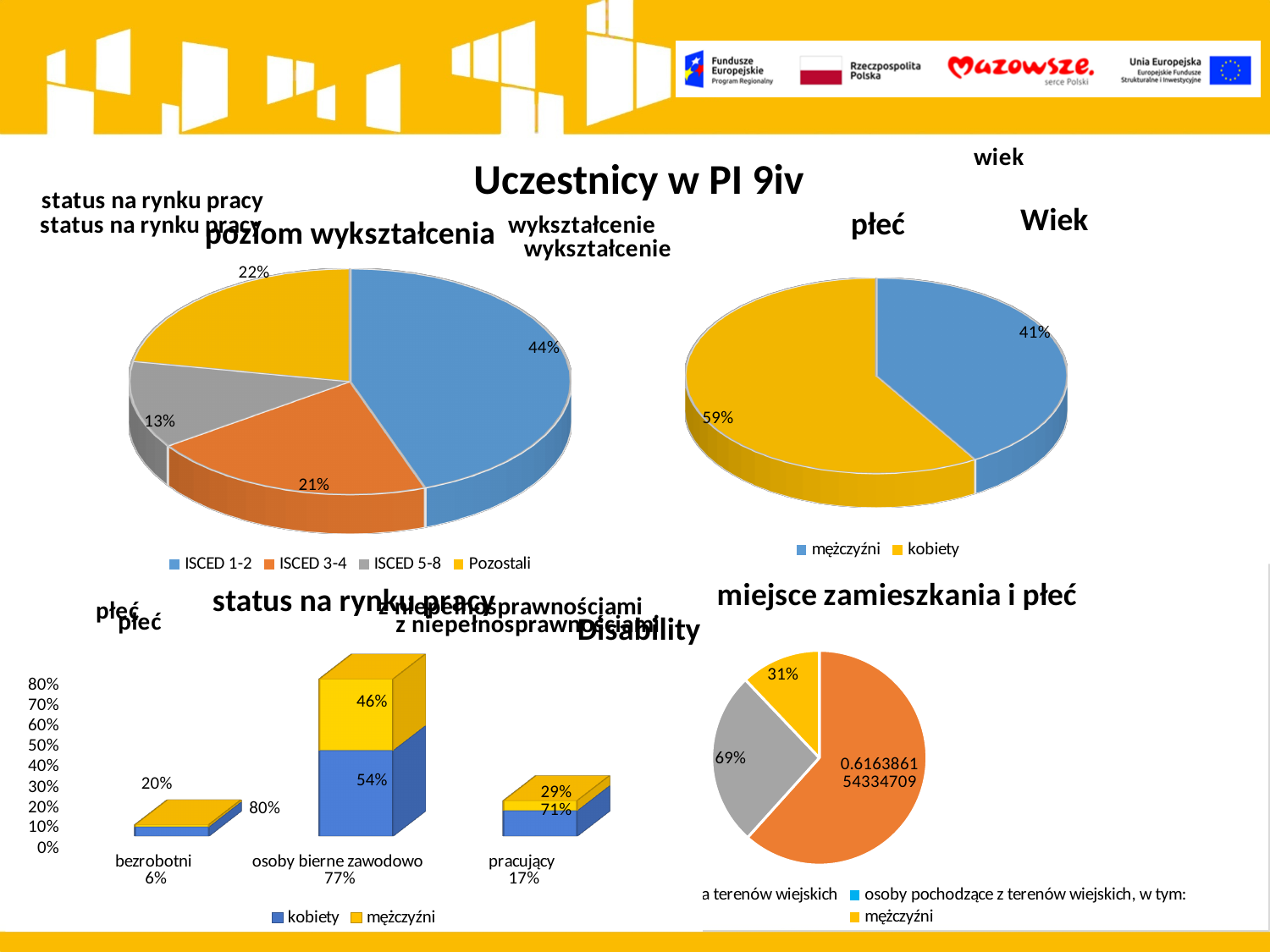
In the 'poziom wykształcenia' pie chart, what share is shown for ISCED 1-2? 44% In the 'status na rynku pracy' bar chart, what value is shown for kobiety in the 'osoby bierne zawodowo' bar? 54% What kind of chart is the 'płeć' chart in the top right? Pie chart In the 'poziom wykształcenia' pie chart, which category has the smallest slice? ISCED 5-8 In the 'poziom wykształcenia' pie chart, which category has the largest slice? ISCED 1-2 How many slices does the 'poziom wykształcenia' pie chart have? 4 How many series does the legend of the 'status na rynku pracy' bar chart list? 2 In the 'płeć' pie chart, what share is shown for kobiety? 59% In the 'płeć' pie chart, which group has the larger share, mężczyźni or kobiety? kobiety In the 'poziom wykształcenia' pie chart, what share is shown for ISCED 5-8? 13% In the 'poziom wykształcenia' pie chart, how many percentage points larger is ISCED 1-2 than ISCED 3-4? 23 percentage points In the 'status na rynku pracy' bar chart, what value is shown for mężczyźni in the 'pracujący' bar? 29%